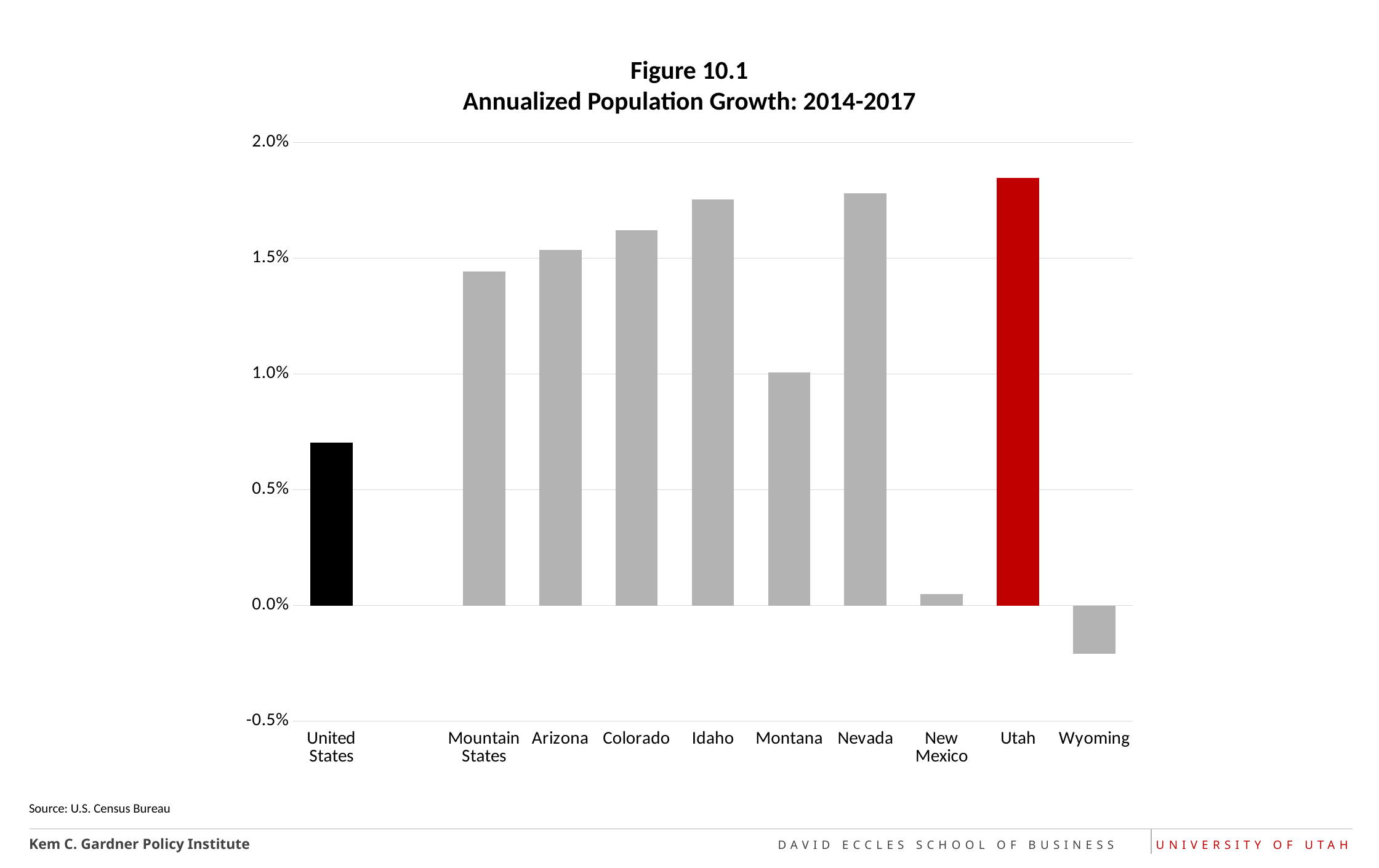
Is the value for United States greater or less than 1.0%? less Is the value for United States greater or less than 0.5%? greater What kind of chart is shown on the slide? bar chart Which category has the lowest annualized population growth? Wyoming Which has the larger value, Colorado or Arizona? Colorado Is the value for Wyoming greater or less than 0.0%? less What colour is the bar for Utah? red How many categories are plotted on the x axis? 10 Which has the larger value, Idaho or Montana? Idaho Which category has the highest annualized population growth? Utah